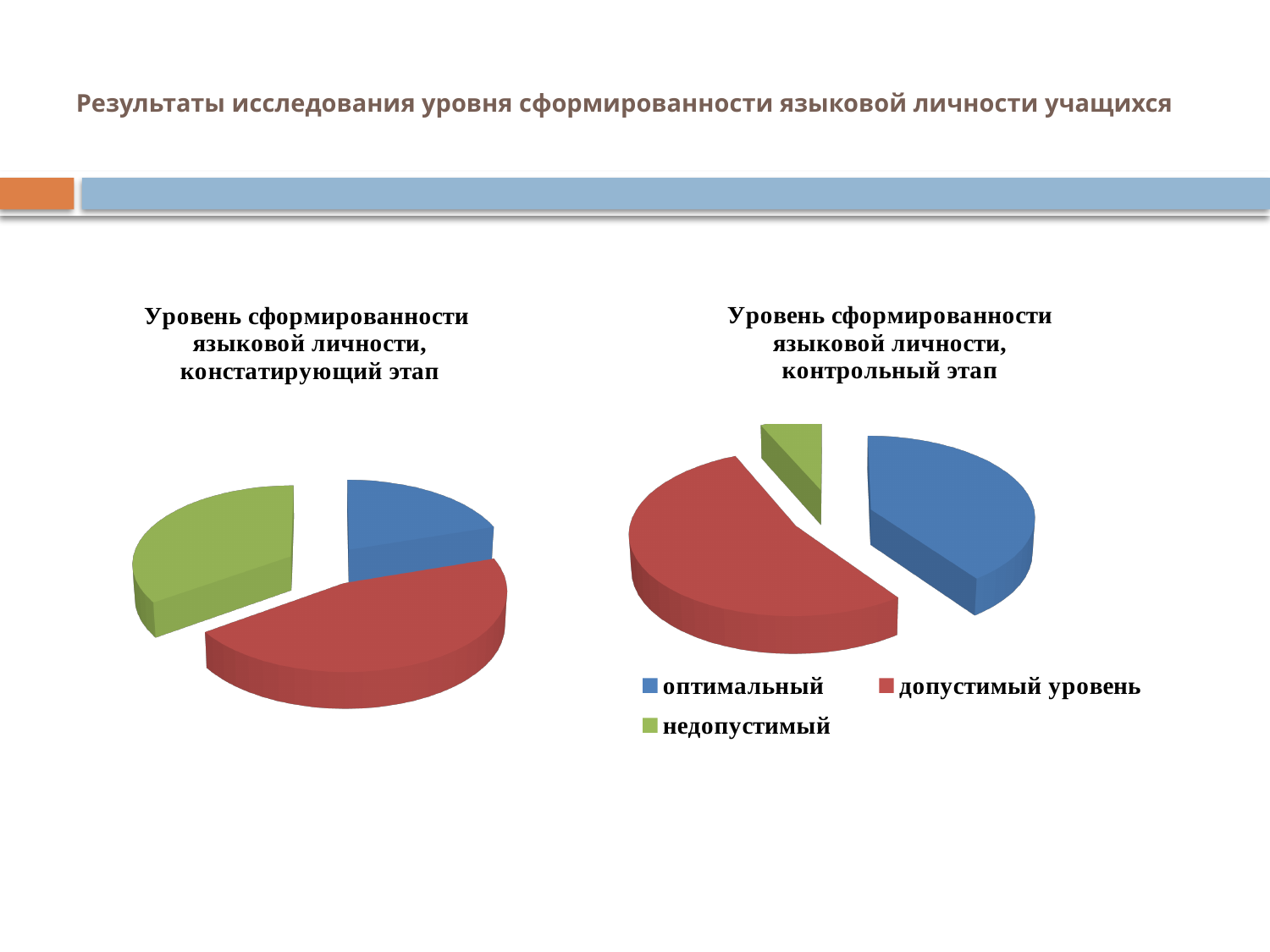
What kind of chart is used on the right, titled "Уровень сформированности языковой личности, контрольный этап"? Pie chart In the left chart (констатирующий этап), which colour slice is the largest? Red In the left chart (констатирующий этап), which slice is larger: the green one or the blue one? Green In the legend of the right chart, which colour represents "оптимальный"? Blue What kind of chart is used on the left, titled "Уровень сформированности языковой личности, констатирующий этап"? Pie chart In the left chart (констатирующий этап), which colour slice is the smallest? Blue How many entries does the legend of the right chart (контрольный этап) list? 3 How many slices does the left pie chart (констатирующий этап) have? 3 How many slices does the right pie chart (контрольный этап) have? 3 In the right chart (контрольный этап), which category has the smallest slice? недопустимый In the right chart (контрольный этап), which category has the largest slice? допустимый уровень In the right chart (контрольный этап), which slice is larger: оптимальный or недопустимый? оптимальный